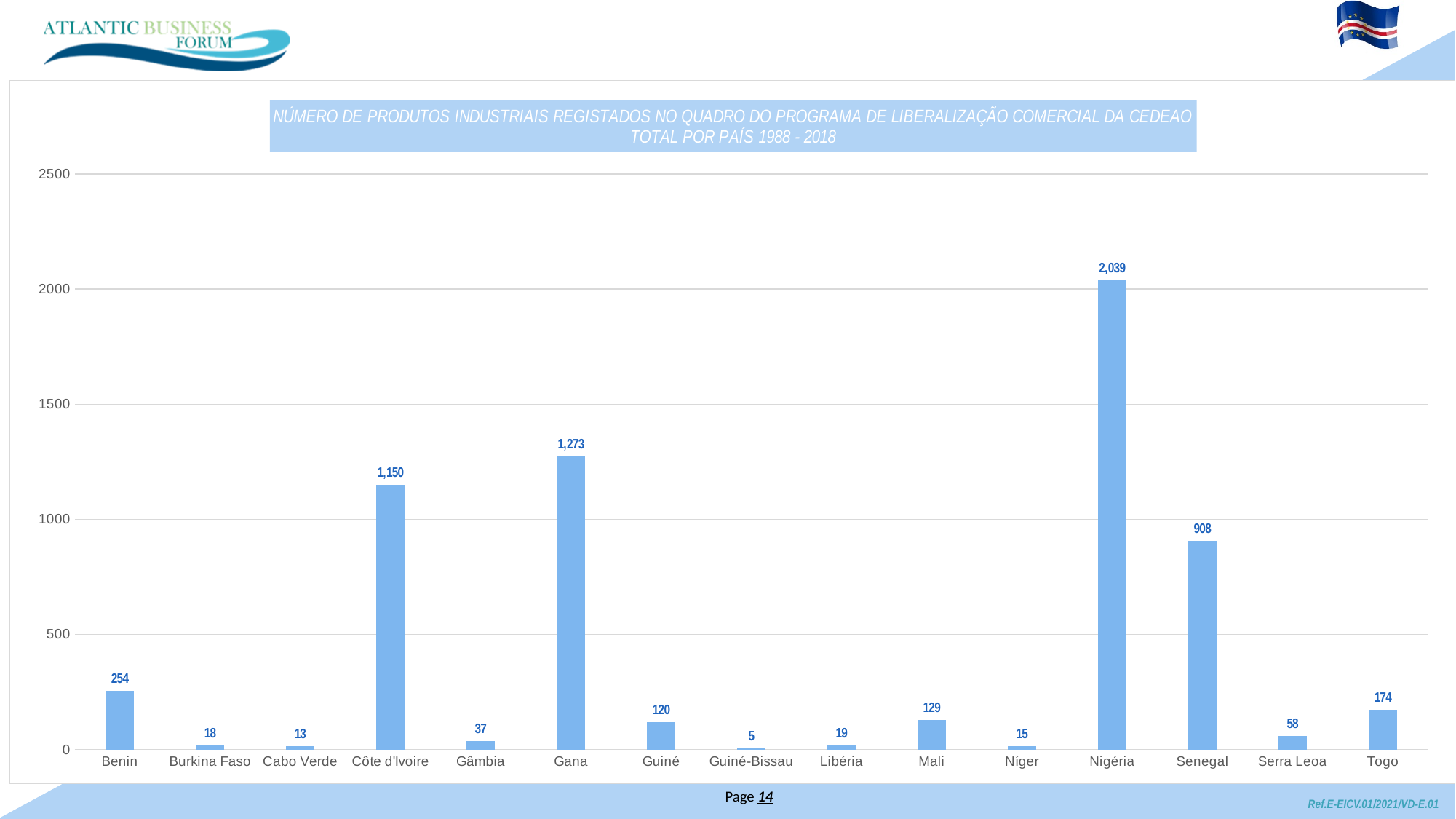
Which country has the highest value? Nigéria What is the difference between the values for Gana and Côte d'Ivoire? 123 Is the value for Senegal greater or less than 1000? less What is the value for Senegal? 908 What kind of chart is shown on the slide? bar chart What is the difference between the values for Nigéria and Senegal? 1,131 Which is larger, the value for Benin or the value for Togo? Benin Which country has the lowest value? Guiné-Bissau How many countries are shown on the x axis? 15 What period does the chart title say the totals cover? 1988 - 2018 What is the value for Nigéria? 2,039 What is the value for Cabo Verde? 13